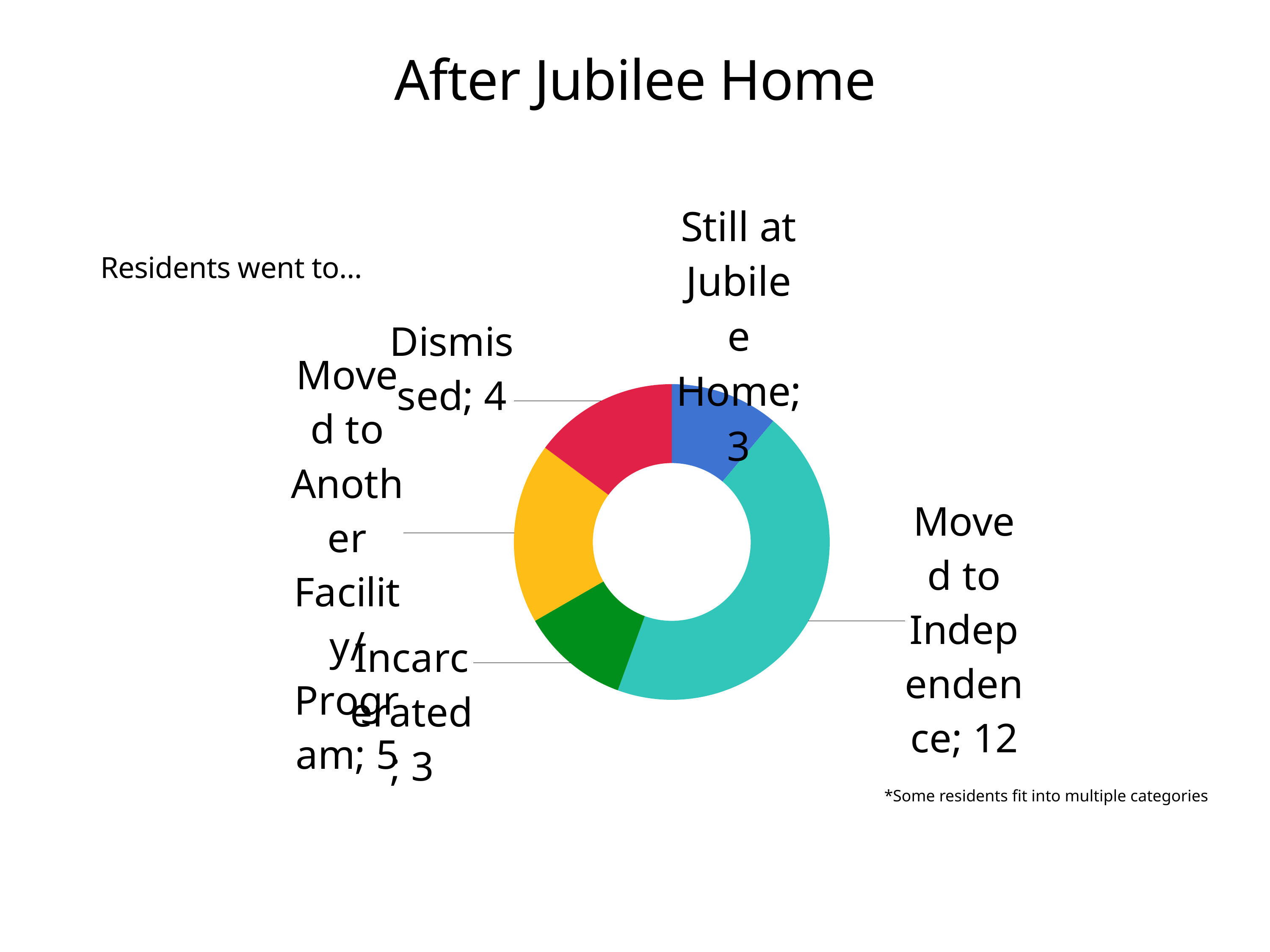
How many residents are still at Jubilee Home? 3 What is the total of all the values shown in the chart? 27 How many residents were incarcerated according to the chart? 3 How many categories does the chart show? 5 Which is larger: Moved to Another Facility/Program or Dismissed? Moved to Another Facility/Program What value is shown for Moved to Another Facility/Program? 5 What is the title of the slide containing the chart? After Jubilee Home What kind of chart is shown on the slide? doughnut chart What value is shown for the Dismissed category? 4 What is the difference between the Moved to Independence value and the Dismissed value? 8 How many residents moved to independence according to the chart? 12 Which category has the largest value in the chart? Moved to Independence